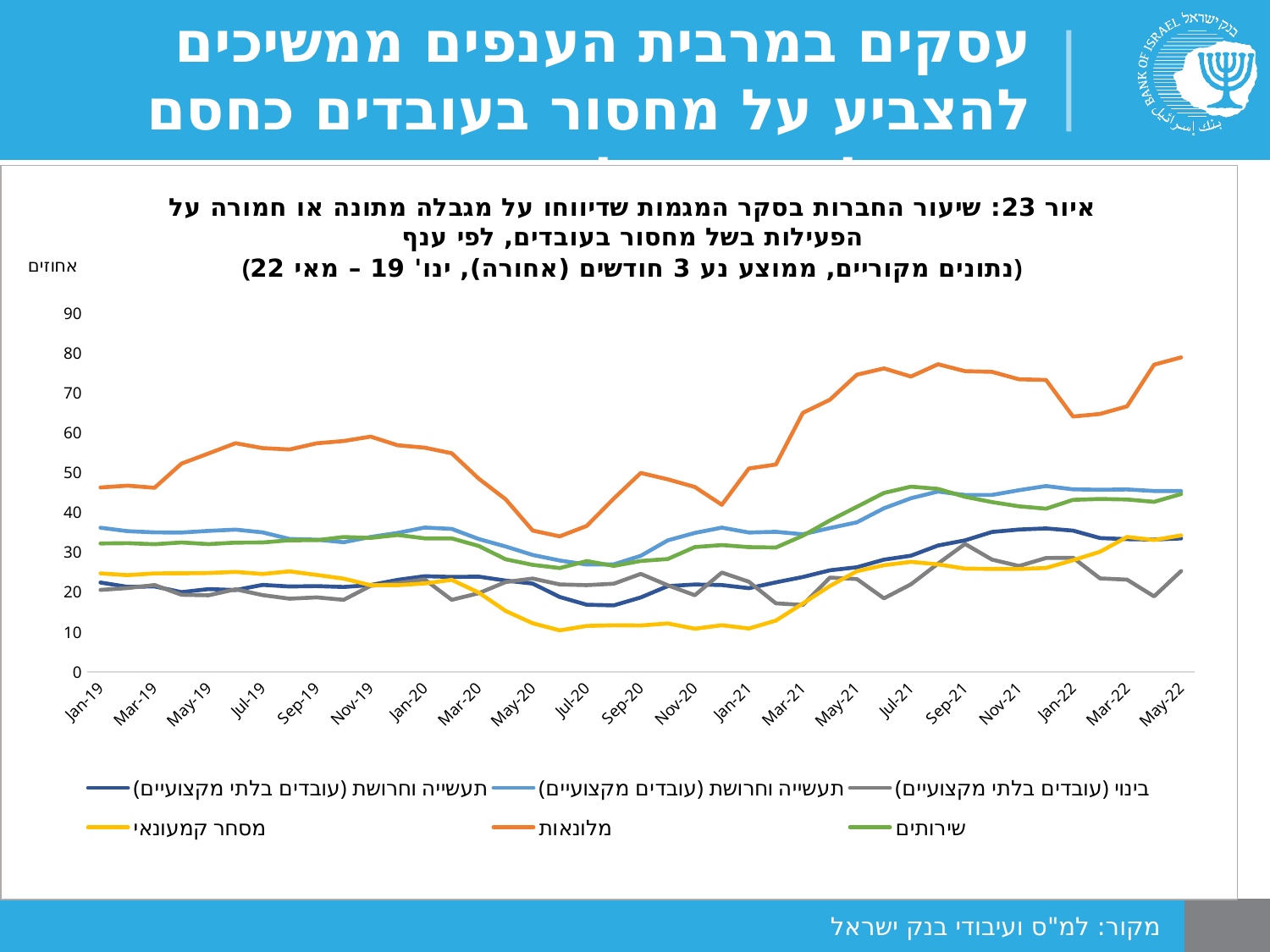
Does the value for מסחר קמעונאי rise or fall between Mar-20 and Jul-20? fall What kind of chart is shown on the slide? line chart Which series has the highest value at May-22? מלונאות What is the label on the vertical axis of the chart? אחוזים Is the value for מלונאות at Jul-20 greater or less than 40? less At May-22, which is larger: the value for מלונאות or the value for שירותים? מלונאות Is the value for מלונאות at May-22 greater or less than 70? greater Does the value for מלונאות rise or fall between Jan-21 and May-21? rise Which series has the lowest value at Jul-20? מסחר קמעונאי What is the highest tick value shown on the vertical axis? 90 Is the value for מסחר קמעונאי at Jul-20 greater or less than 20? less How many series does the legend list? 6